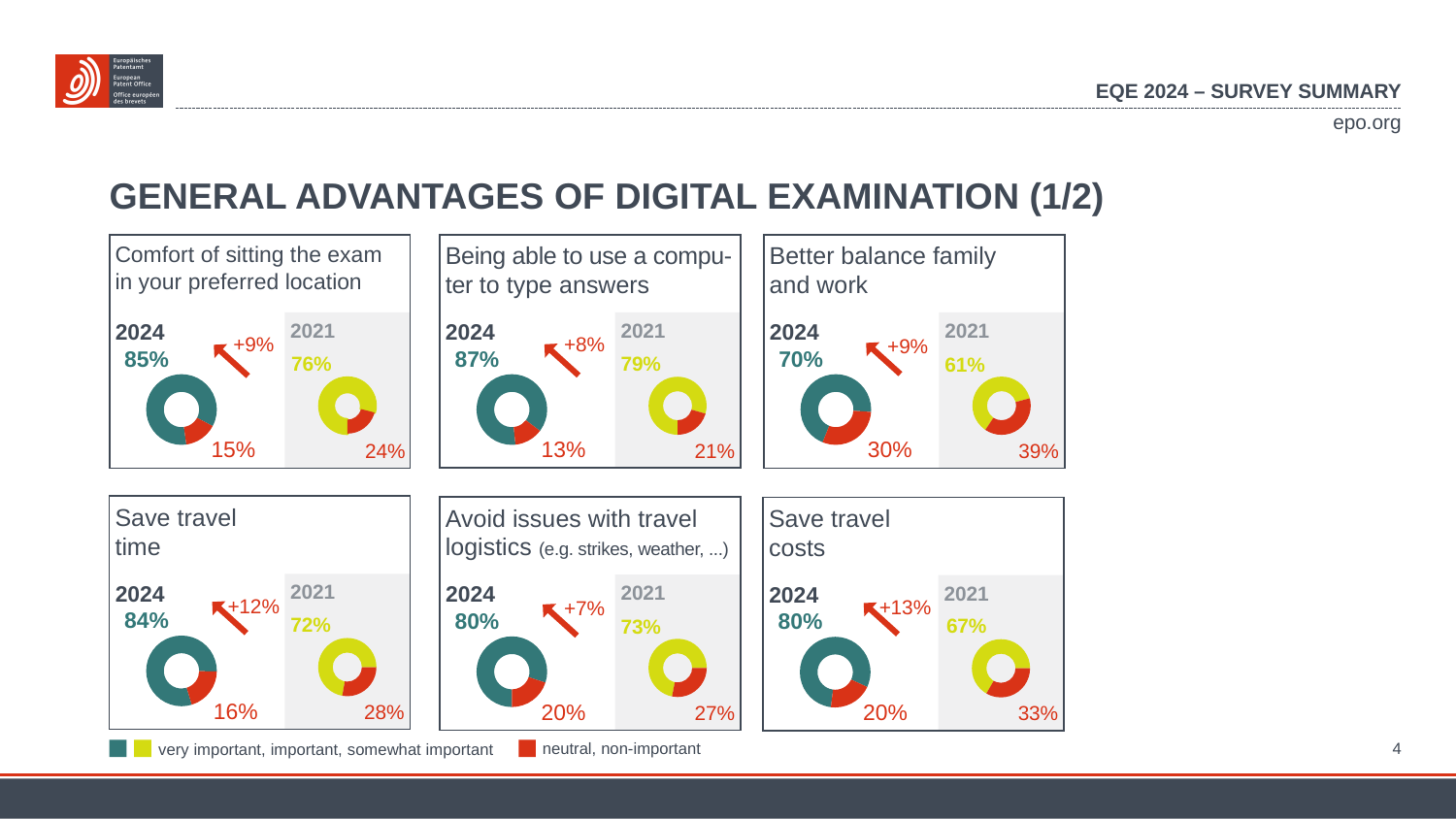
In the 'Save travel time' chart, what is the change from 2021 to 2024 shown next to the arrow? +12% Across the six advantages, which one has the highest 2024 share for very important, important or somewhat important? Being able to use a computer to type answers In the 'Avoid issues with travel logistics' chart, what is the difference between the 2024 and 2021 shares for very important, important or somewhat important? 7% In the 'Comfort of sitting the exam in your preferred location' chart, what share of respondents rated it very important, important or somewhat important in 2024? 85% Is the 2024 share for 'Save travel time' larger or smaller than the 2024 share for 'Save travel costs' (very important, important or somewhat important)? larger What kind of chart is used to show the survey results in each panel? Donut (pie) chart In the 'Better balance family and work' chart, what share of respondents answered neutral or non-important in 2024? 30% In the 'Save travel costs' chart, what was the neutral/non-important share in 2021? 33% Which advantage shows the largest increase from 2021 to 2024? Save travel costs Across the six advantages, which one has the lowest 2024 share for very important, important or somewhat important? Better balance family and work How many advantages of digital examination are shown on this slide? 6 In the 'Being able to use a computer to type answers' chart, what was the 2021 share for very important, important or somewhat important? 79%